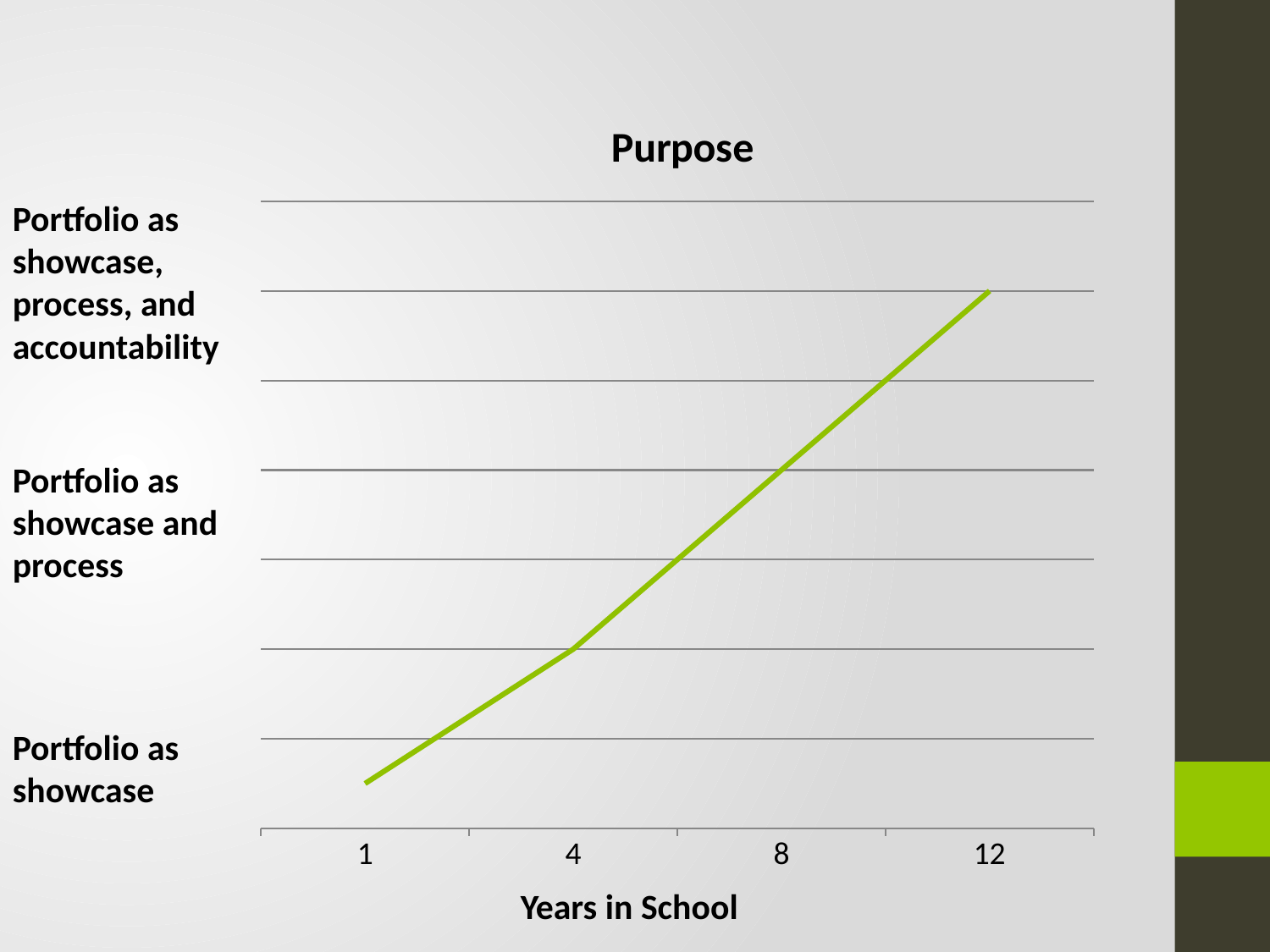
What kind of chart is shown on the slide? line chart Which year in school has the highest value on the line? 12 How many lines are plotted on the chart? 1 What is the title of the chart? Purpose What is the title of the x axis? Years in School How many points are plotted along the x axis? 4 What are the x-axis category labels, from left to right? 1, 4, 8, 12 Does the line rise or fall as years in school increase from 1 to 12? rise Which year in school has the lowest value on the line? 1 Which has the larger value, year 8 or year 4? 8 Which has the larger value, year 1 or year 12? 12